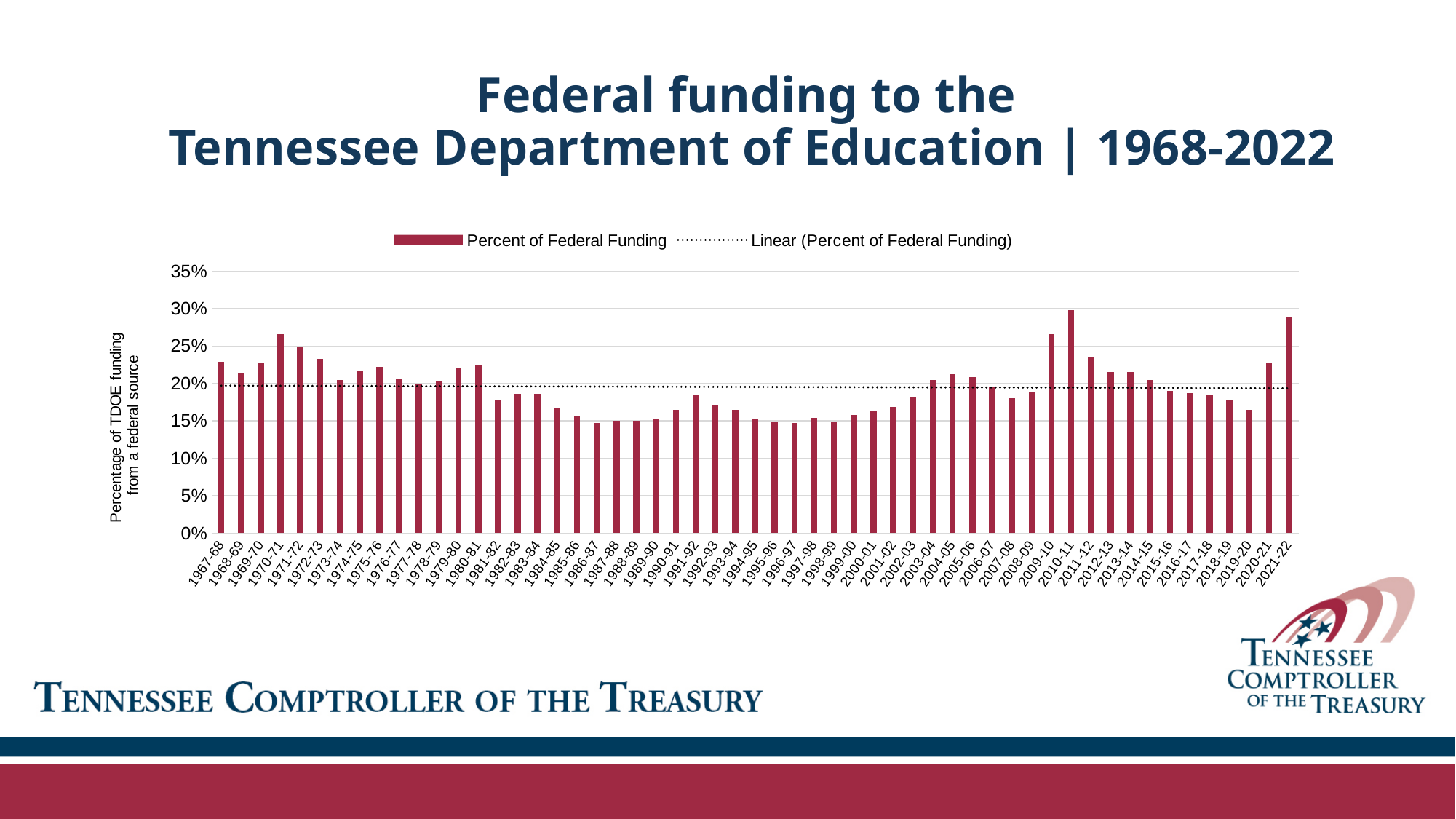
What is the label on the vertical axis of the chart? Percentage of TDOE funding from a federal source Is the value for 1985-86 greater or less than 20%? less Is the value for 2019-20 greater or less than 20%? less How many entries does the chart legend list? 2 Which is larger, the value for 1970-71 or the value for 1971-72? 1970-71 Which school year has the highest percent of federal funding? 2010-11 Is the value for 1970-71 greater or less than 25%? greater Do the values rise or fall from 1980-81 to 1986-87? fall Which is larger, the value for 2010-11 or the value for 2011-12? 2010-11 How many school years (bars) are plotted on the chart? 55 What kind of chart is shown on the slide? bar chart